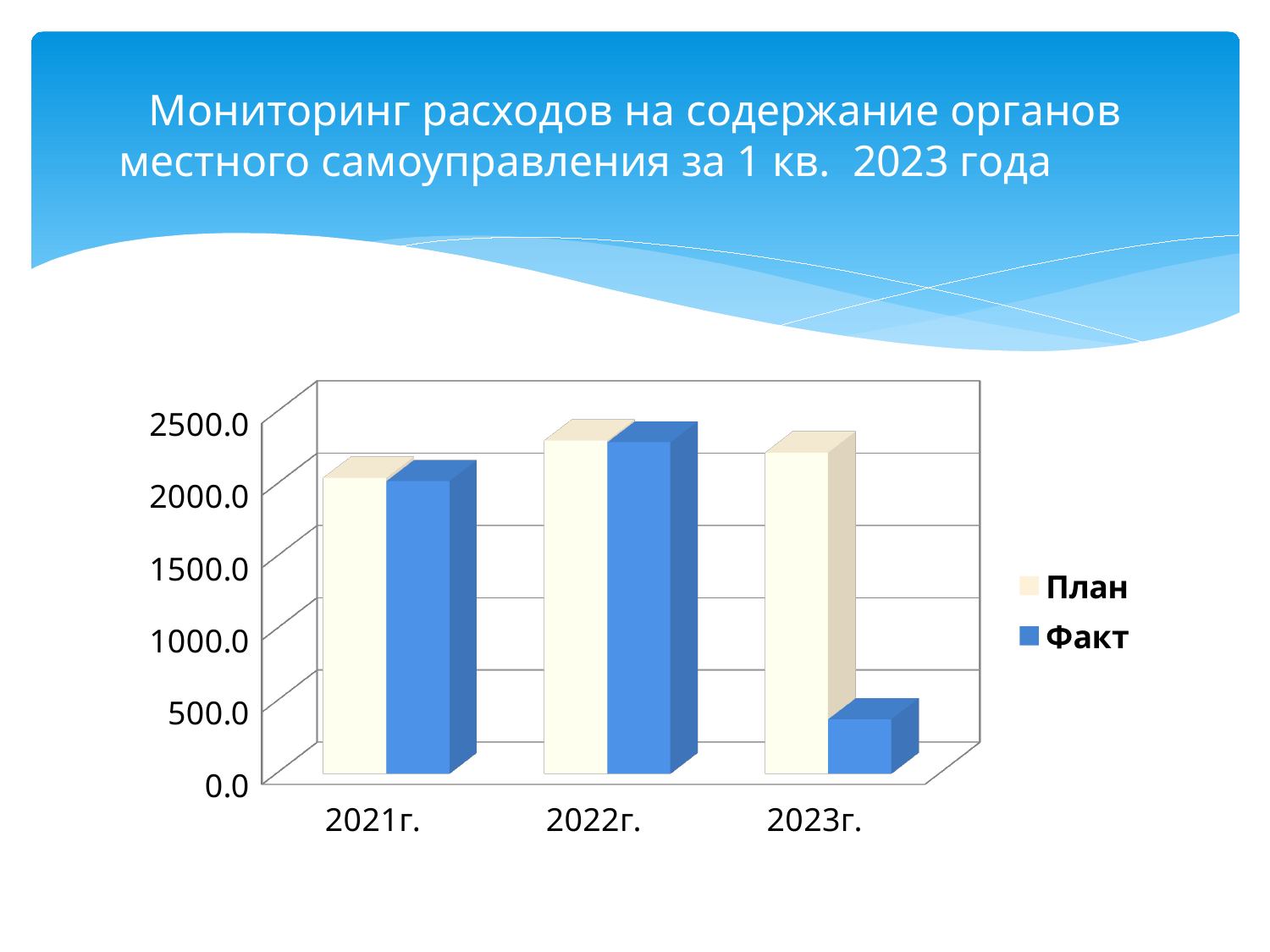
How many series does the legend list? 2 What are the two series named in the legend? План and Факт For 2023г., which is larger, План or Факт? План Which year has the lowest Факт value? 2023г. Is the План value for 2022г. greater or less than 2000.0? greater Which year has the highest Факт value? 2022г. Is the Факт value for 2023г. greater or less than 500.0? less Is the Факт value for 2021г. greater or less than 1500.0? greater Which is larger, the Факт value for 2021г. or for 2022г.? 2022г. How many year categories are shown on the x axis? 3 What kind of chart is shown on the slide? bar chart Which year has the lowest План value? 2021г.